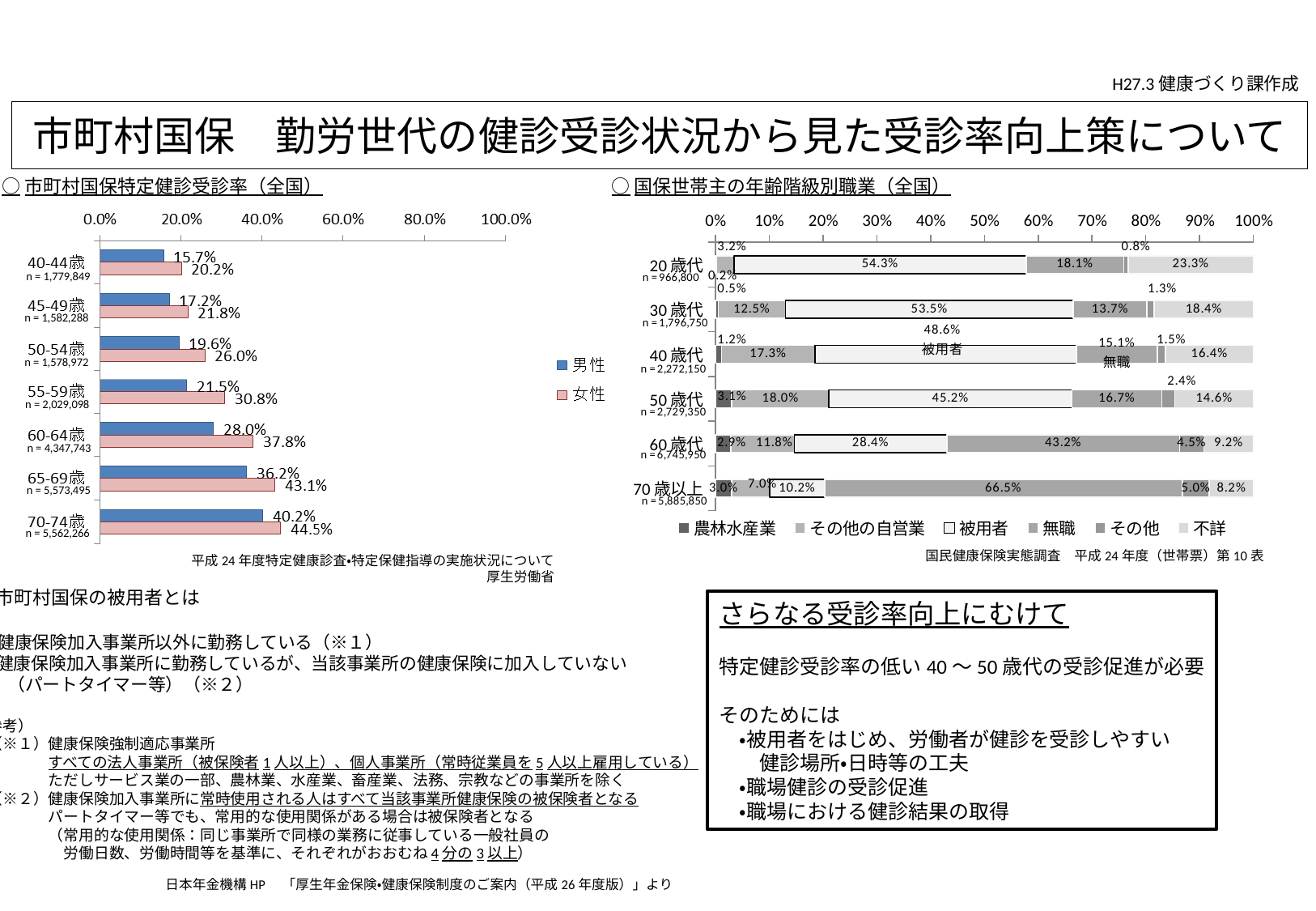
In the 市町村国保特定健診受診率（全国） chart, which age group has the highest 女性 value? 70-74歳 In the 市町村国保特定健診受診率（全国） chart, what is the difference between the 女性 and 男性 values for the 60-64歳 group? 9.8% In the 国保世帯主の年齢階級別職業（全国） chart, what is the 無職 share for the 70歳以上 group? 66.5% How many series does the legend of the 国保世帯主の年齢階級別職業（全国） chart list? 6 In the 国保世帯主の年齢階級別職業（全国） chart, which is larger for the 60歳代 group: 被用者 or 無職? 無職 In the 国保世帯主の年齢階級別職業（全国） chart, what is the 被用者 share for the 40歳代 group? 48.6% In the 市町村国保特定健診受診率（全国） chart, how many age groups are shown? 7 In the 市町村国保特定健診受診率（全国） chart, what is the value for 男性 in the 40-44歳 group? 15.7% In the 市町村国保特定健診受診率（全国） chart, which age group has the lowest 男性 value? 40-44歳 In the 市町村国保特定健診受診率（全国） chart, do the 男性 values rise or fall as the age groups get older? rise In the 市町村国保特定健診受診率（全国） chart, what is the value for 女性 in the 55-59歳 group? 30.8% What kind of chart is the 市町村国保特定健診受診率（全国） chart? bar chart